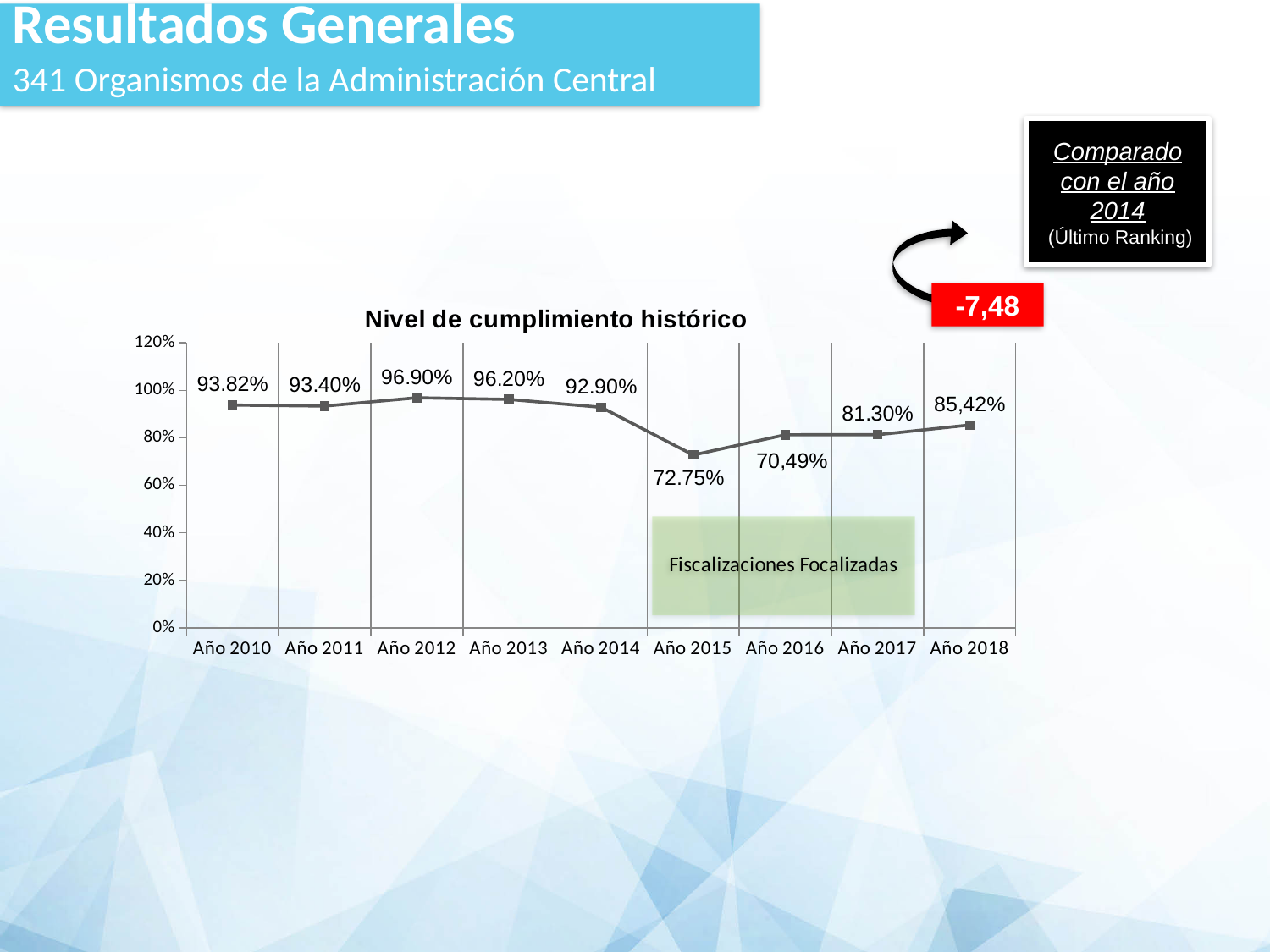
How many years are plotted on the chart? 9 What is the value for Año 2015? 72.75% Is the value for Año 2015 greater or less than 80%? less What kind of chart is shown? line chart Which year has the highest value? Año 2012 What is the value for Año 2018? 85,42% What is the difference between the values for Año 2012 and Año 2013? 0.70 percentage points What is the difference between the values for Año 2014 and Año 2015? 20.15 percentage points What is the title of the chart? Nivel de cumplimiento histórico What is the value for Año 2010? 93.82% What is the value for Año 2017? 81.30% Which is larger, the value for Año 2010 or the value for Año 2014? Año 2010